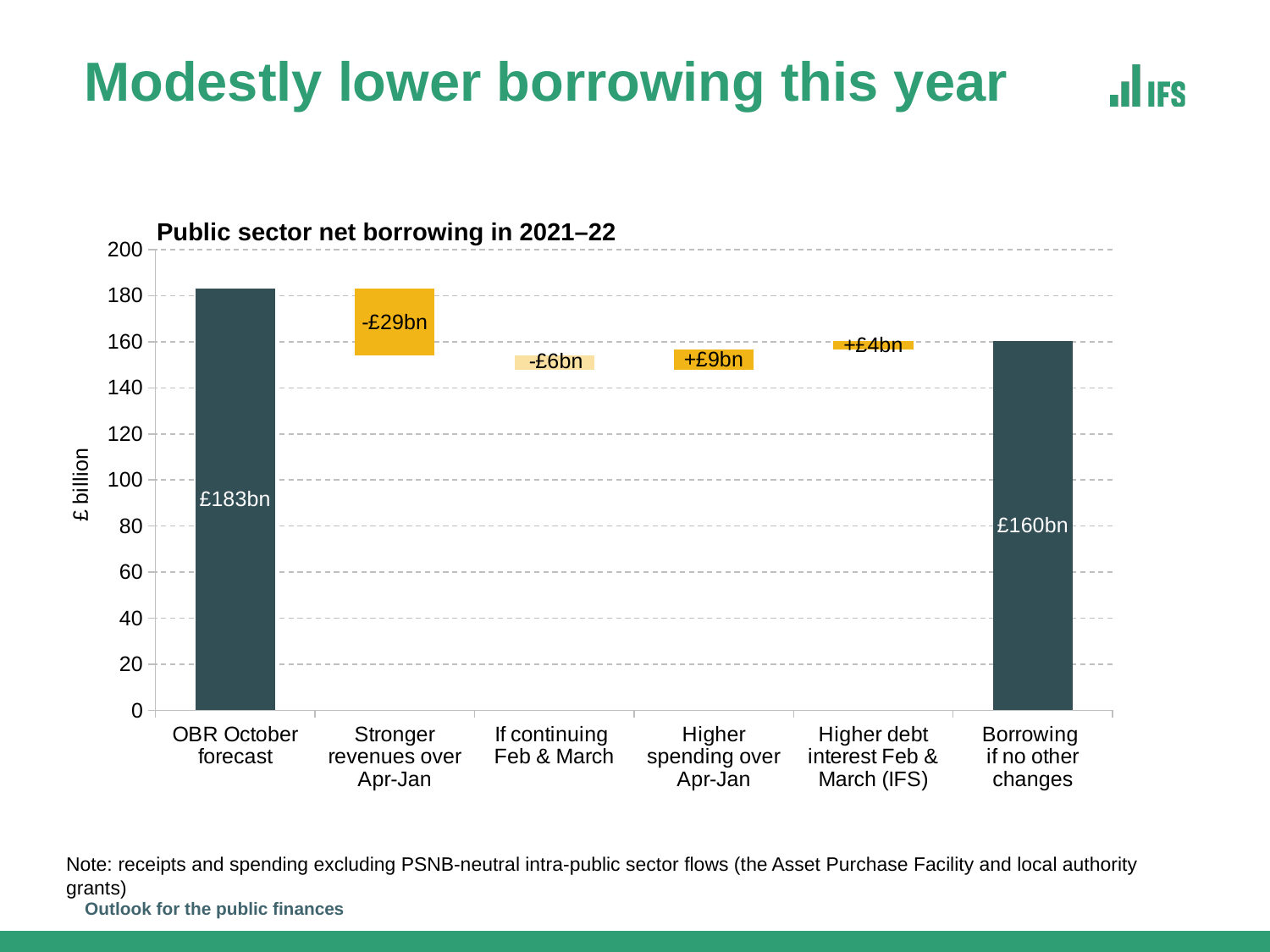
How many categories are shown on the x axis? 6 What is the value labelled on the 'Stronger revenues over Apr-Jan' bar? -£29bn Which is larger: the adjustment for 'Higher spending over Apr-Jan' or for 'Higher debt interest Feb & March (IFS)'? Higher spending over Apr-Jan What is the value labelled on the 'If continuing Feb & March' bar? -£6bn What is the value labelled on the 'Higher spending over Apr-Jan' bar? +£9bn Which adjustment has the smallest magnitude? Higher debt interest Feb & March (IFS) What is the value shown for the OBR October forecast? £183bn By how much is 'Borrowing if no other changes' lower than the OBR October forecast? £23bn What is the value shown for 'Borrowing if no other changes'? £160bn What is the title of the chart? Public sector net borrowing in 2021–22 Which category has the highest borrowing value? OBR October forecast What is the value labelled on the 'Higher debt interest Feb & March (IFS)' bar? +£4bn